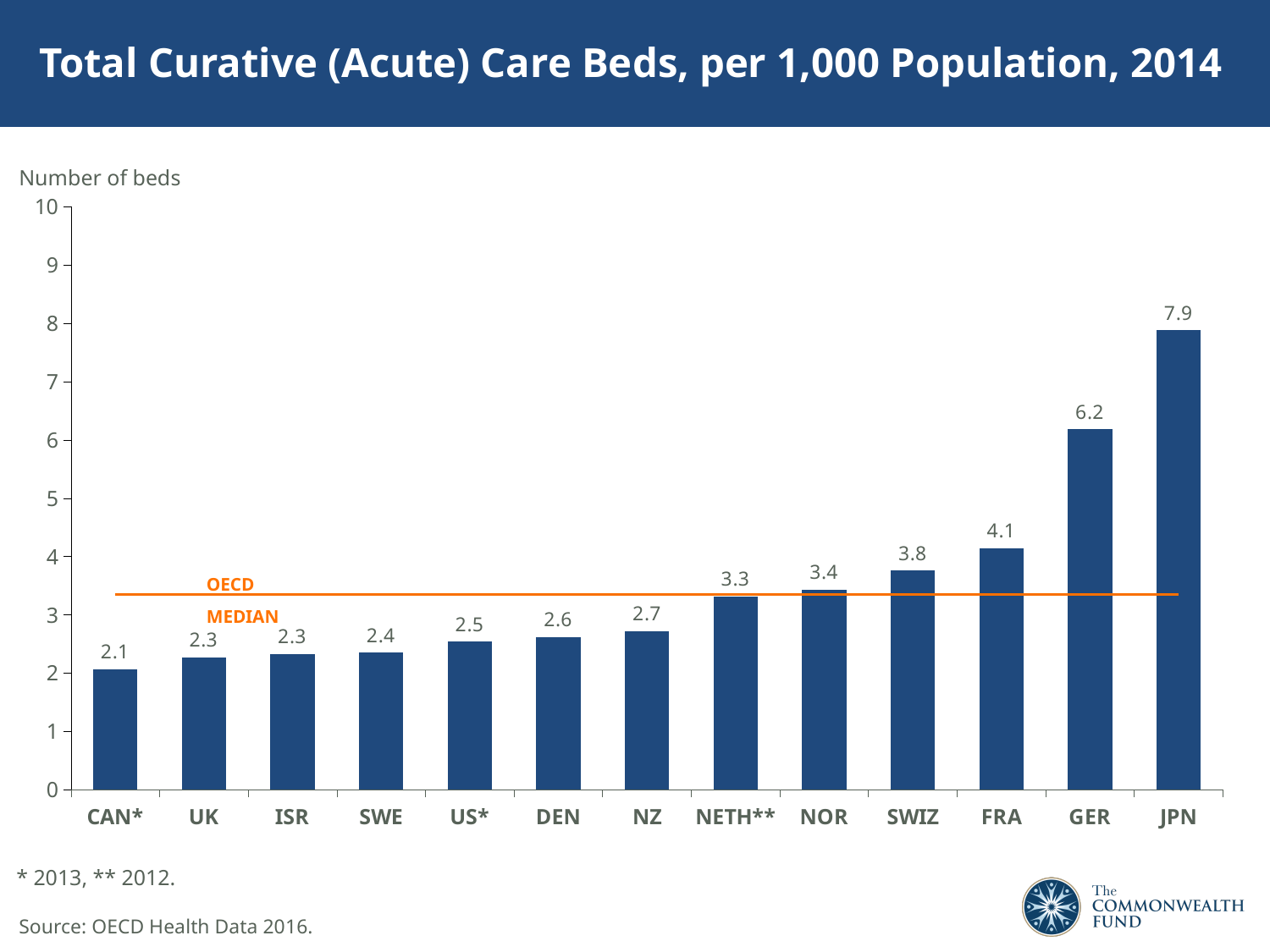
How many countries are shown on the chart? 13 What is the value shown for NETH**? 3.3 Which country has the highest number of curative care beds per 1,000 population? JPN What is the value shown for US*? 2.5 What does the orange horizontal line on the chart represent? OECD median Which country has the lowest number of curative care beds per 1,000 population? CAN* Is the value for GER greater or less than 5? greater What is the difference between the values for GER and FRA? 2.1 Do the values rise or fall from left to right along the x axis? Rise What is the number of curative care beds per 1,000 population for JPN? 7.9 Which has a higher value, SWIZ or NOR? SWIZ What kind of chart is shown on the slide? Bar chart